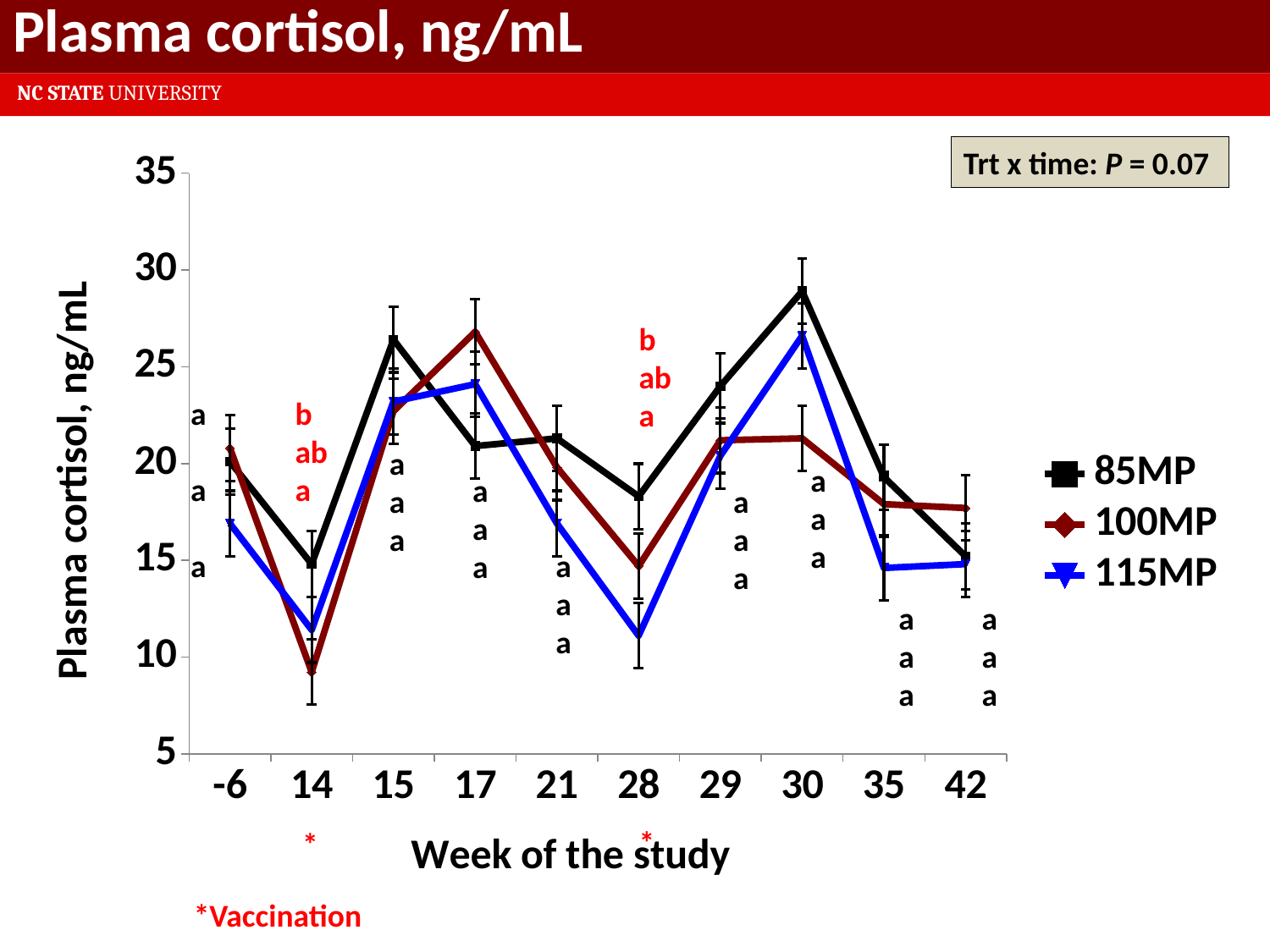
What P value is given for the treatment by time interaction? 0.07 How many series does the legend list? 3 At which week does the 85MP series reach its highest plasma cortisol value? 30 Does the 85MP series rise or fall from week 28 to week 30? rise What kind of chart is shown on the slide? line chart How many weeks are shown on the x axis? 10 At week 28, which series has the higher plasma cortisol value, 85MP or 115MP? 85MP At which week does the 100MP series reach its lowest plasma cortisol value? 14 Is the value for 115MP at week 30 greater or less than 25? greater At week 17, which series has the higher plasma cortisol value, 100MP or 85MP? 100MP Is the value for 85MP at week 30 greater or less than 25? greater Is the value for 100MP at week 14 greater or less than 15? less